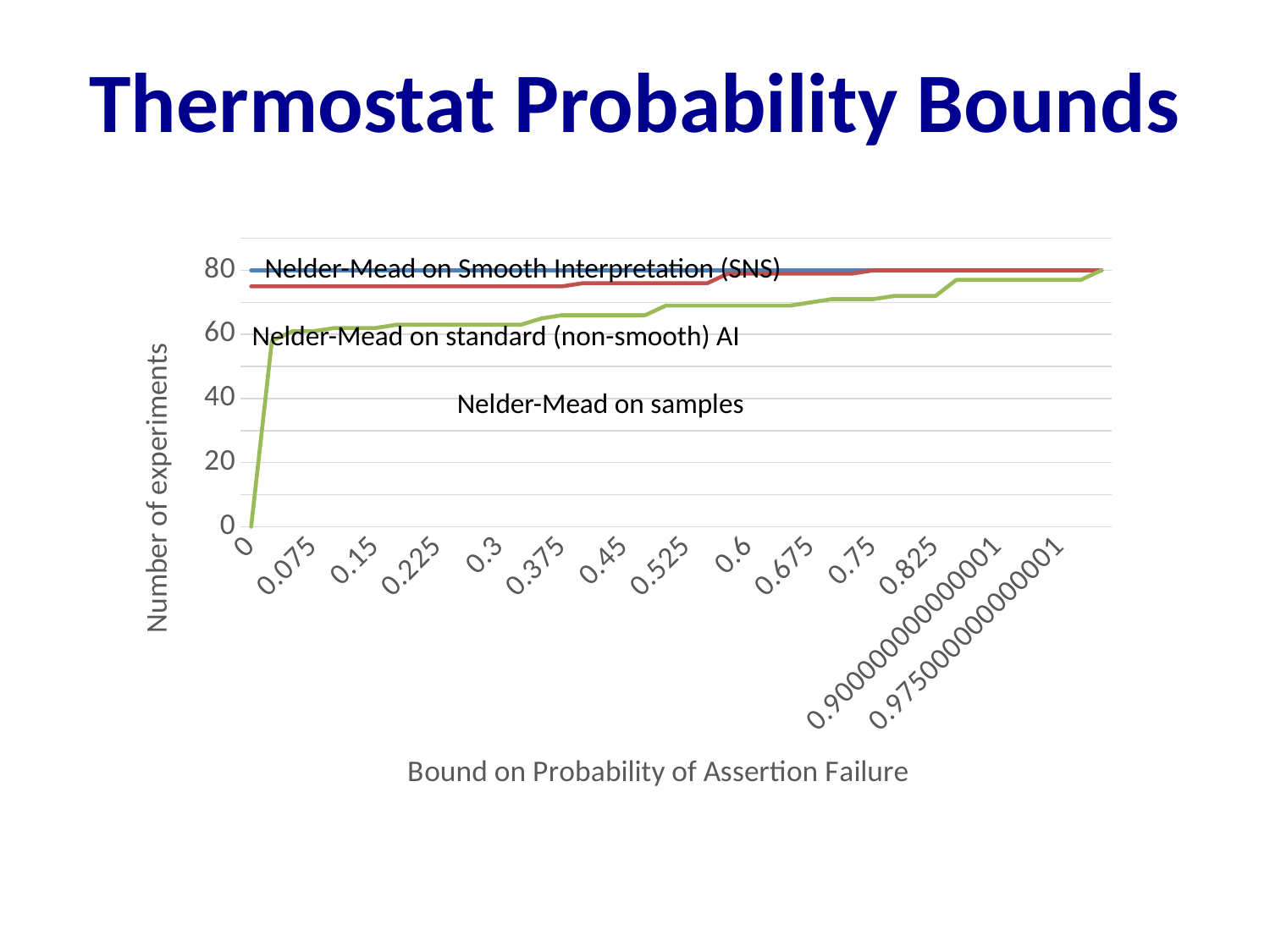
How many series are plotted on the chart? 3 What kind of chart is shown on the slide? line chart Which series has the lowest value at a bound of 0.3? Nelder-Mead on samples Does the Nelder-Mead on samples line rise or fall as the bound on probability increases? rises Does the Nelder-Mead on standard (non-smooth) AI line rise or fall along the x axis? rises What is the value of the Nelder-Mead on samples line at a bound of 0? 0 Which series has the highest value at a bound of 0.3? Nelder-Mead on Smooth Interpretation (SNS) Is the value of the Nelder-Mead on samples line at a bound of 0.6 greater or less than 80? less What is the title of the vertical axis? Number of experiments Is the value of the Nelder-Mead on samples line at a bound of 0.45 greater or less than 60? greater What is the title of the horizontal axis? Bound on Probability of Assertion Failure Is the value of the Nelder-Mead on standard (non-smooth) AI line at a bound of 0.075 greater or less than 80? less